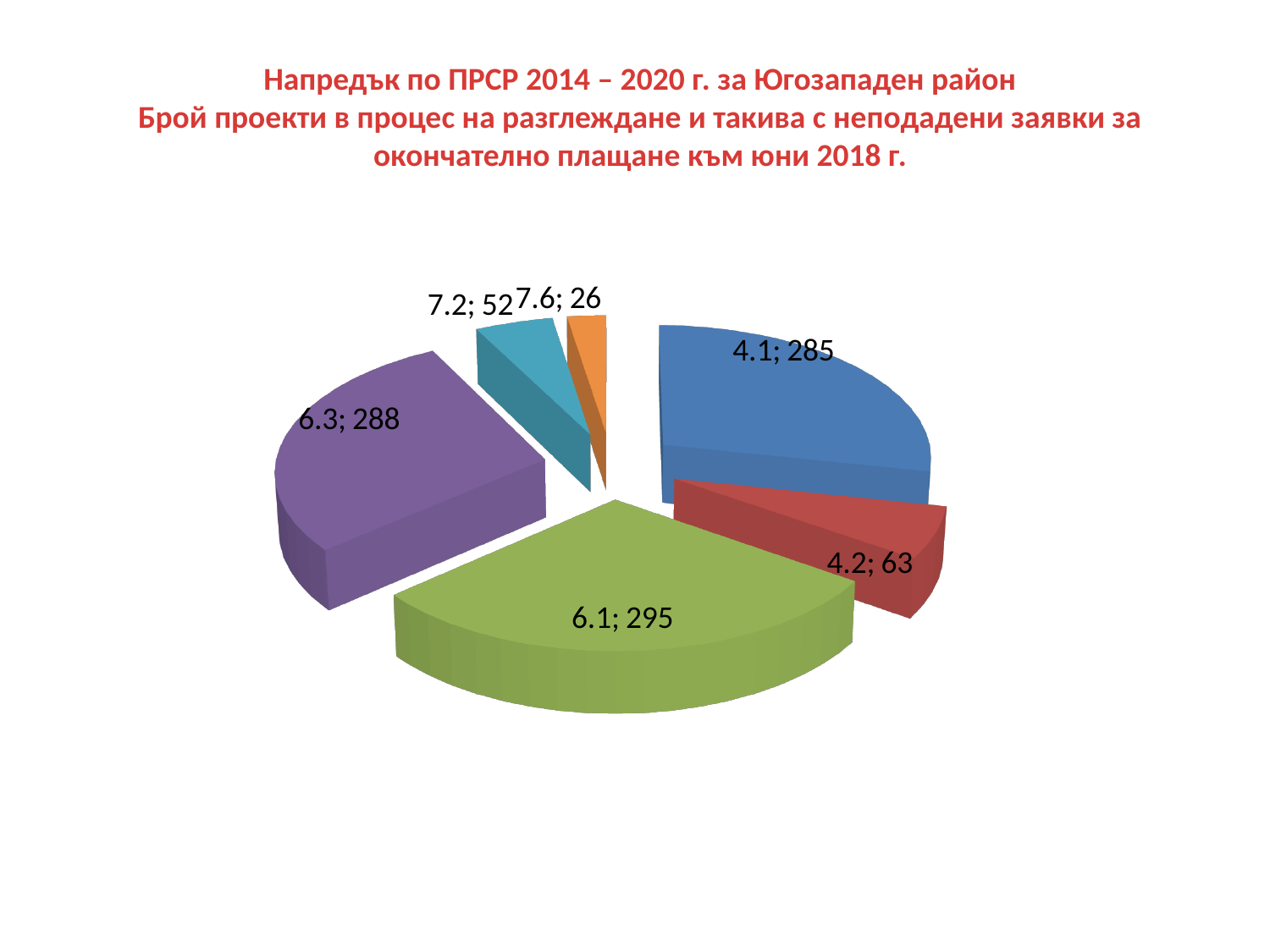
Which is larger, the value for 4.2 or the value for 7.2? 4.2 What share of the pie does the slice for 6.1 represent? 29.2% How many slices does the pie chart have? 6 Which region is named in the chart title? Югозападен район Which measure has the largest slice in the pie chart? 6.1 What is the value shown for measure 7.6? 26 What kind of chart is shown on the slide? pie chart What is the difference between the values for 6.3 and 7.2? 236 Which measure has the smallest slice in the pie chart? 7.6 What is the value shown for measure 6.1? 295 What is the value shown for measure 4.2? 63 What is the value shown for measure 4.1? 285